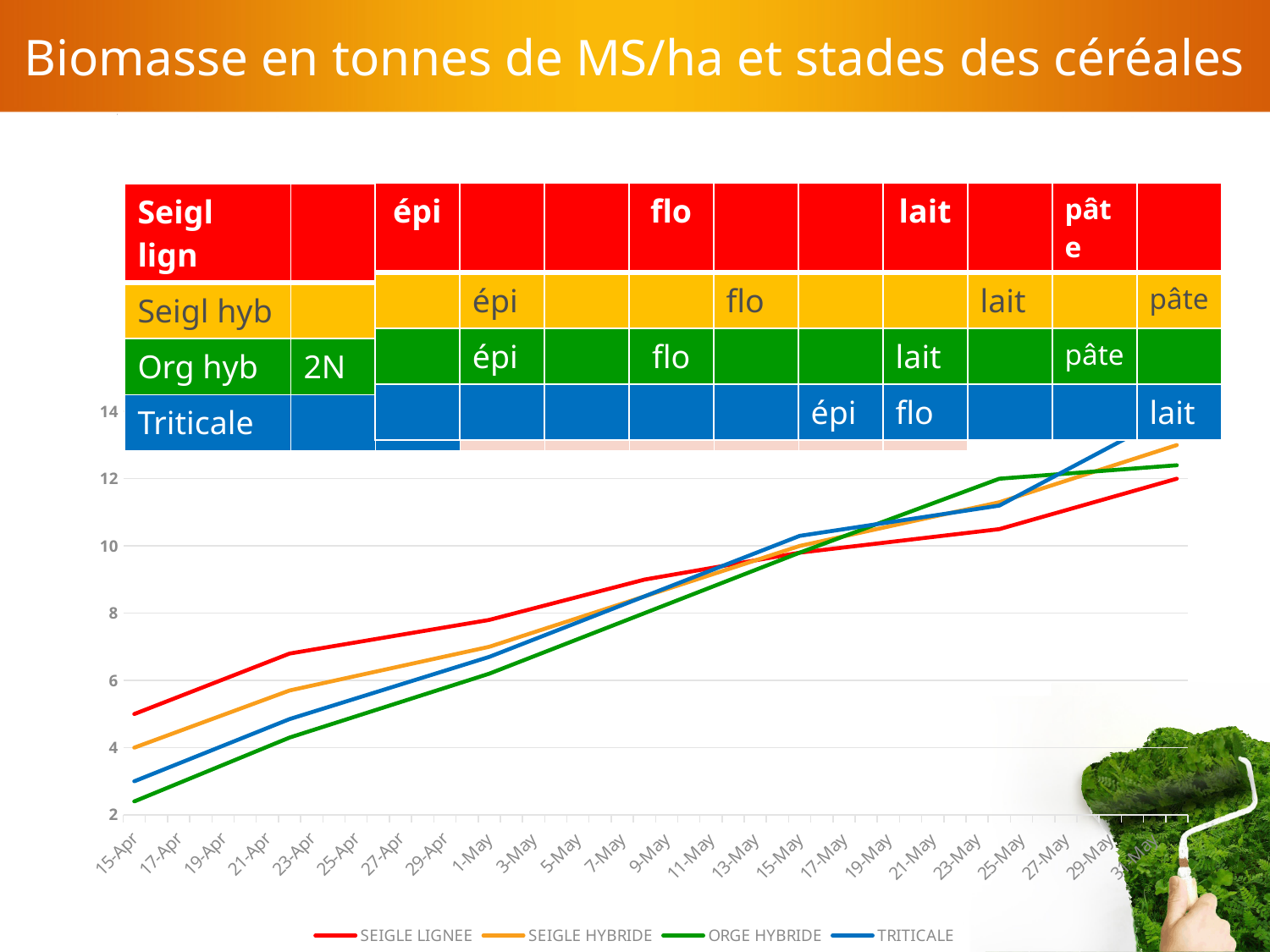
At 15-Apr, which is larger: the value for SEIGLE LIGNEE or the value for TRITICALE? SEIGLE LIGNEE What is the title of the slide chart? Biomasse en tonnes de MS/ha et stades des céréales What kind of chart is shown on the slide? line chart Is the value for ORGE HYBRIDE at 31-May greater or less than 10? greater Is the value for TRITICALE at 31-May greater or less than 12? greater Is the value for ORGE HYBRIDE at 15-Apr greater or less than 4? less Which series is plotted in red? SEIGLE LIGNEE Which series has the highest value at 15-Apr? SEIGLE LIGNEE Which series has the lowest value at 15-Apr? ORGE HYBRIDE Do the values of the SEIGLE LIGNEE series rise or fall from 15-Apr to 31-May? rise How many series does the chart legend list? 4